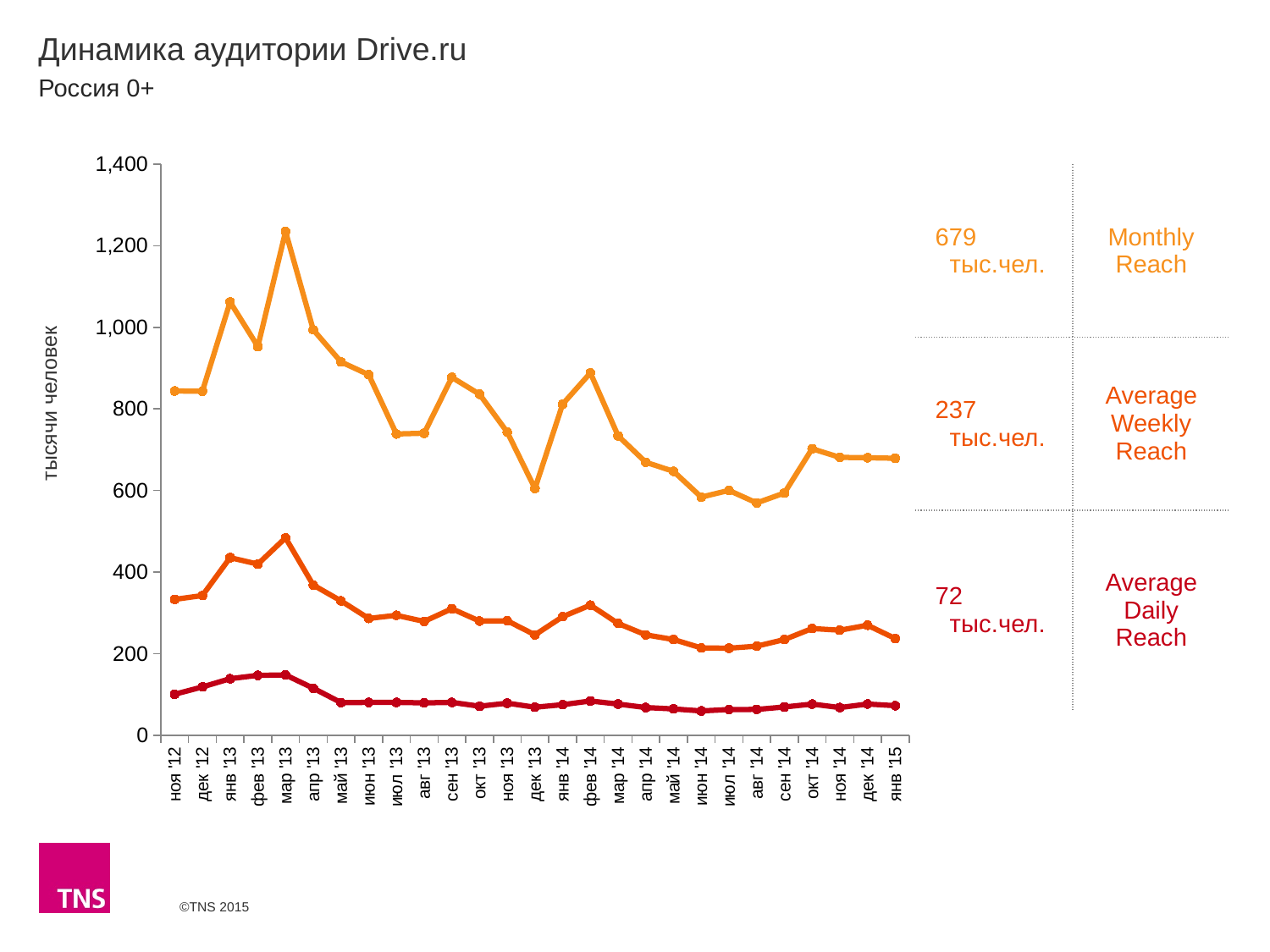
What kind of chart is shown on the slide? line chart How many series are plotted on the chart? 3 Is the Monthly Reach value for мар '13 greater or less than 1,200? greater Is the Average Weekly Reach value for мар '13 greater or less than 400? greater Is the Average Daily Reach value for мар '13 greater or less than 200? less What Monthly Reach value is printed in the panel beside the chart? 679 тыс.чел. How many monthly data points does each line have on the x axis? 27 In which month does the Monthly Reach line reach its highest point? мар '13 In which month does the Average Weekly Reach line reach its highest point? мар '13 Which is larger, the Monthly Reach for янв '13 or for фев '13? янв '13 Does the Monthly Reach line rise or fall from мар '13 to дек '13? fall